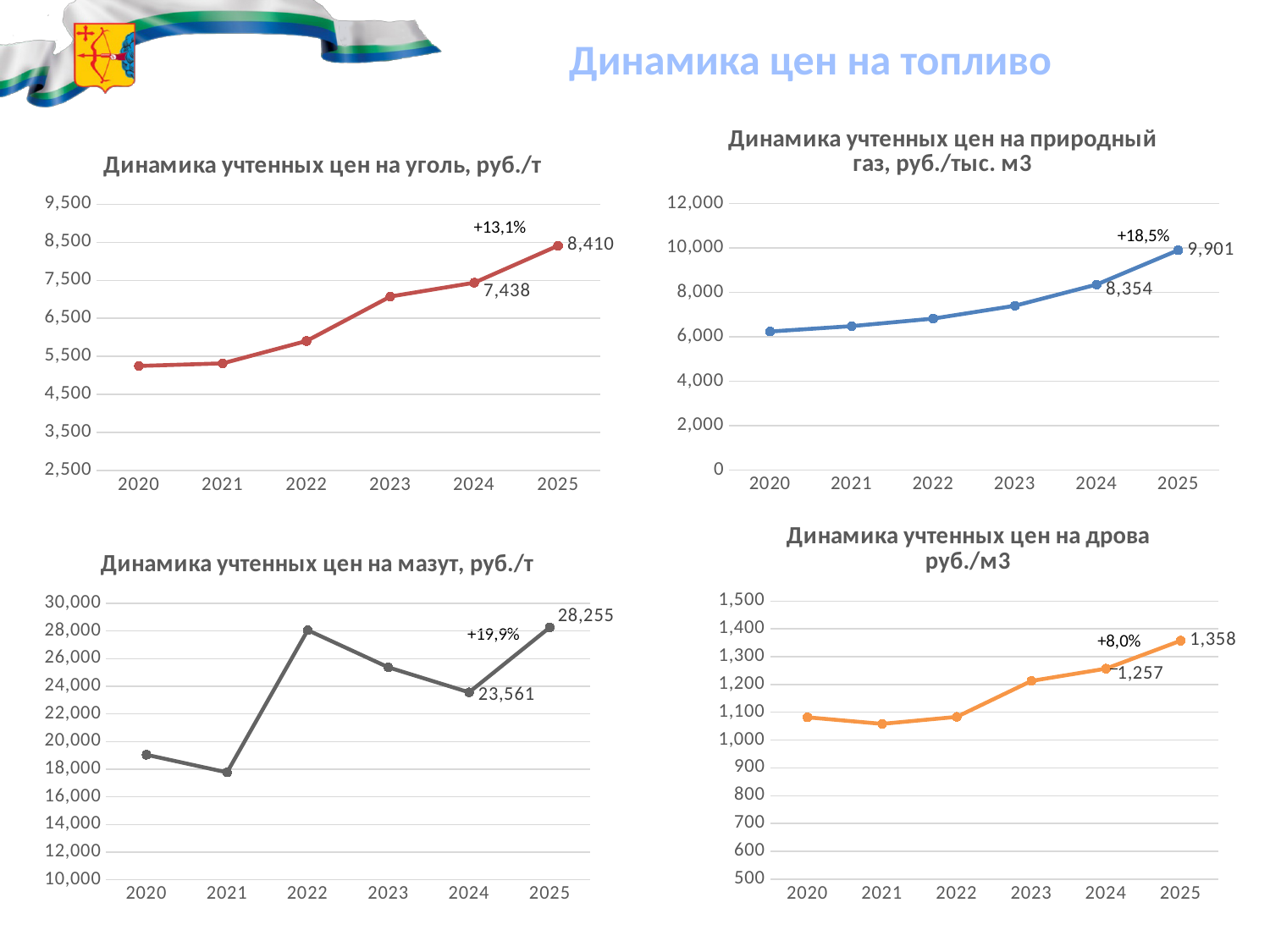
In the chart "Динамика учтенных цен на мазут, руб./т", what is the value for 2025? 28,255 In the chart "Динамика учтенных цен на природный газ, руб./тыс. м3", what is the value for 2024? 8,354 What type of chart is used for "Динамика учтенных цен на уголь, руб./т"? line chart In the chart "Динамика учтенных цен на дрова руб./м3", what is the difference between the 2025 and 2024 values? 101 In the chart "Динамика учтенных цен на уголь, руб./т", what is the difference between the 2025 and 2024 values? 972 In the chart "Динамика учтенных цен на природный газ, руб./тыс. м3", what percentage change is annotated between 2024 and 2025? +18,5% In the chart "Динамика учтенных цен на природный газ, руб./тыс. м3", do the values rise or fall from 2020 to 2025? rise In the chart "Динамика учтенных цен на мазут, руб./т", how many years are plotted? 6 In the chart "Динамика учтенных цен на мазут, руб./т", which year has the lowest value? 2021 In the chart "Динамика учтенных цен на уголь, руб./т", is the value for 2020 greater or less than 5,500? less In the chart "Динамика учтенных цен на дрова руб./м3", is the value for 2021 greater or less than 1,000? greater In the chart "Динамика учтенных цен на уголь, руб./т", what is the value for 2025? 8,410